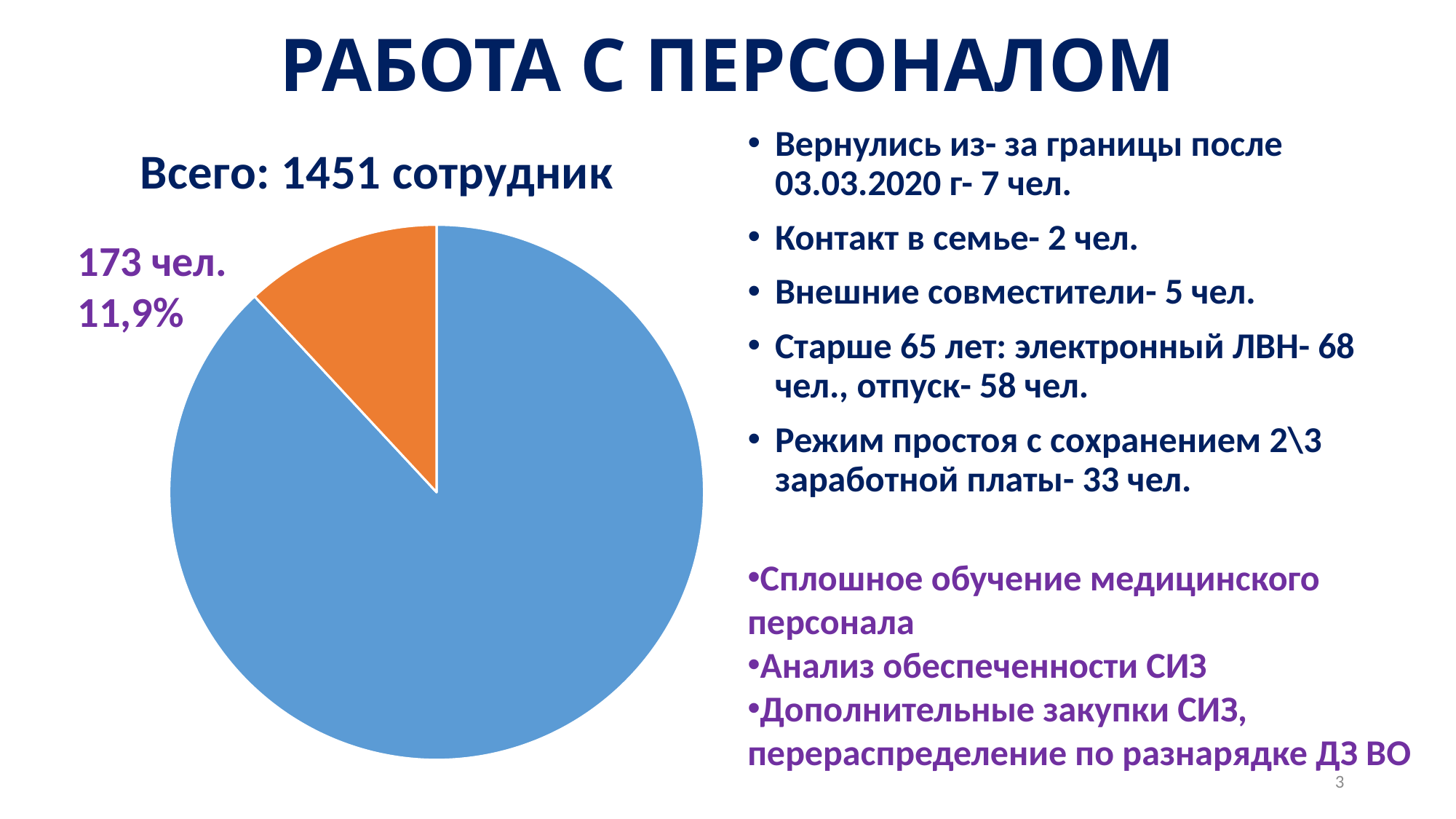
What share of the pie does the orange slice represent? 11,9% What is the total number of employees stated above the pie chart? 1451 сотрудник Given the total of 1451 employees and 173 in the orange slice, how many employees does the blue slice represent? 1278 How many people does the orange slice of the pie chart represent? 173 чел. How many slices does the pie chart have? 2 What colour is the largest slice of the pie chart? blue What is the heading printed above the pie chart? Всего: 1451 сотрудник What kind of chart is shown on the slide? pie chart Which slice of the pie chart is the smallest? the orange slice (173 чел.) Which slice of the pie chart is larger, the blue one or the orange one? blue Is the share of the orange slice greater or less than 25%? less